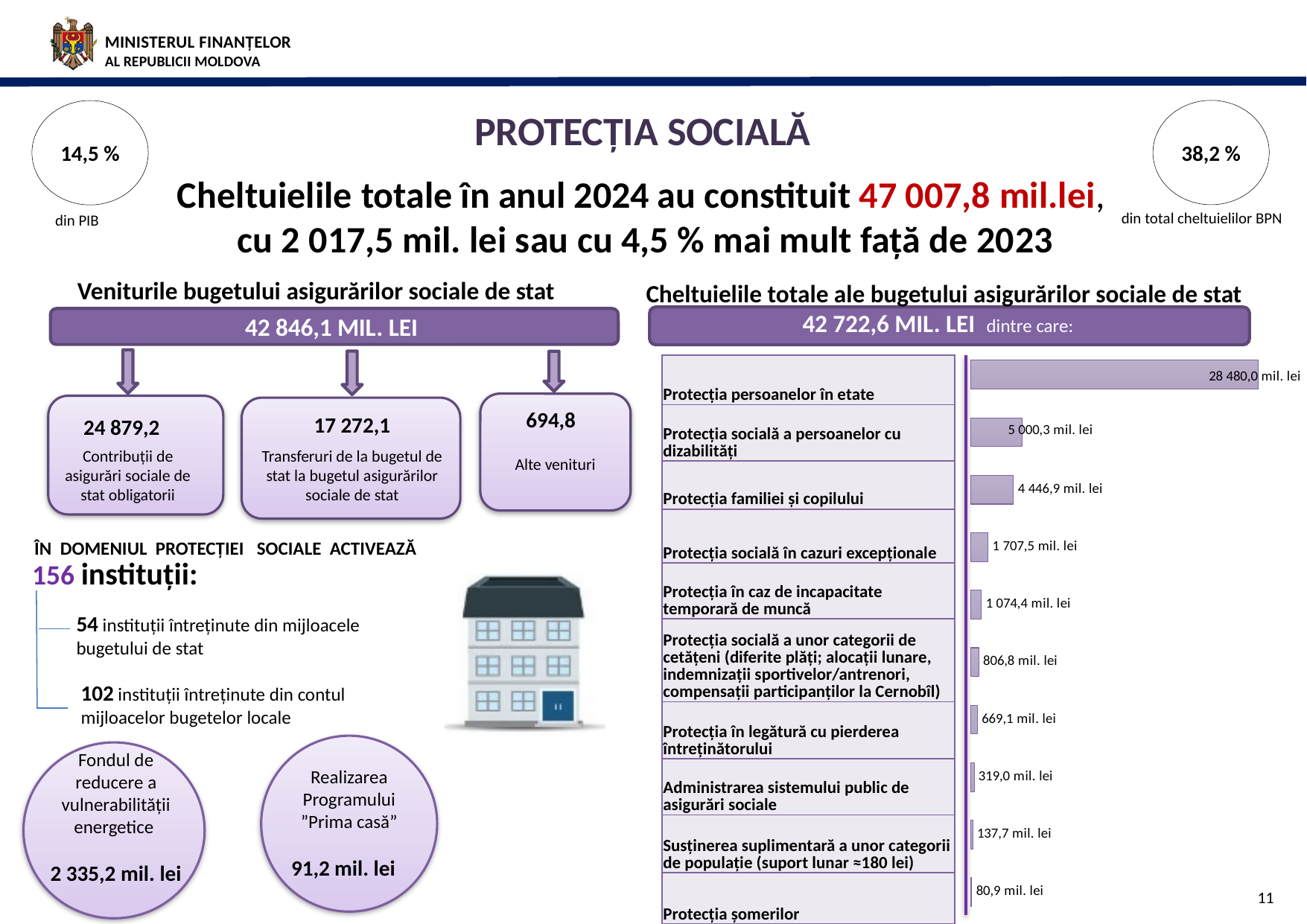
In the bar chart on the right, what is the difference between Protecția socială a persoanelor cu dizabilități and Protecția familiei și copilului? 553,4 mil. lei In the bar chart on the right, what is the value for Protecția familiei și copilului? 4 446,9 mil. lei In the bar chart on the right, do the values rise or fall going from the top category to the bottom category? Fall What kind of chart is shown on the right side of the slide? Bar chart In the bar chart on the right, what is the value for Administrarea sistemului public de asigurări sociale? 319,0 mil. lei In the bar chart on the right, what is the difference between Protecția socială în cazuri excepționale and Protecția în caz de incapacitate temporară de muncă? 633,1 mil. lei In the bar chart on the right, what is the value for Protecția persoanelor în etate? 28 480,0 mil. lei In the bar chart on the right, which category has the lowest value? Protecția șomerilor In the bar chart on the right, what is the value for Protecția șomerilor? 80,9 mil. lei In the bar chart on the right, which category has the highest value? Protecția persoanelor în etate In the bar chart on the right, which is larger: Protecția în legătură cu pierderea întreținătorului or Administrarea sistemului public de asigurări sociale? Protecția în legătură cu pierderea întreținătorului How many categories does the bar chart on the right show? 10